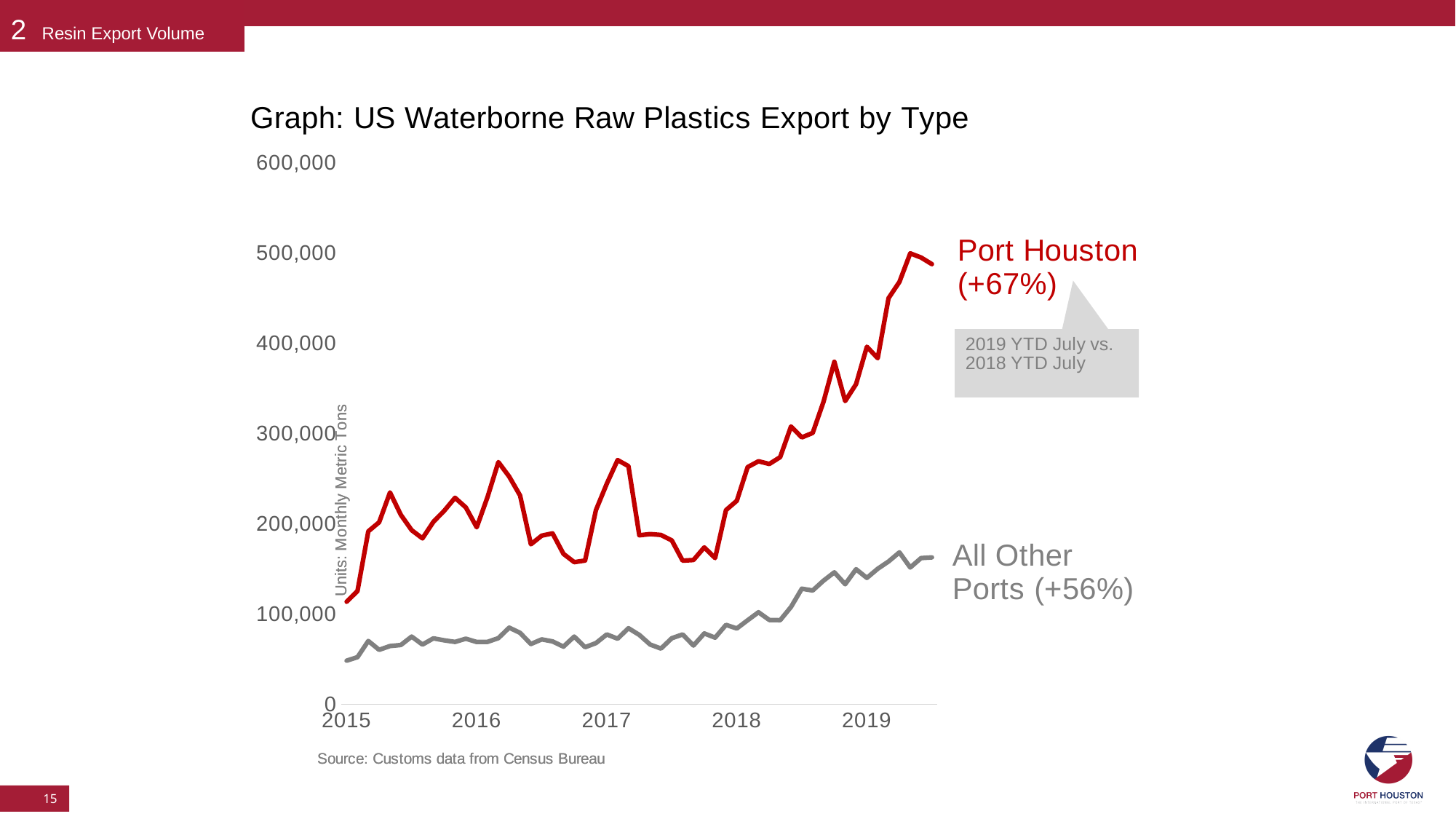
Which series has the higher values in 2019, Port Houston or All Other Ports? Port Houston Does the Port Houston line generally rise or fall from 2015 to 2019? Rise What percentage change is shown next to the All Other Ports line? +56% Is the value for All Other Ports at the start of 2015 greater or less than 100,000? less What kind of chart is shown on the slide? Line chart What percentage change is shown next to the Port Houston line? +67% What is the title of the chart? Graph: US Waterborne Raw Plastics Export by Type Does the All Other Ports line generally rise or fall from 2015 to 2019? Rise How many series are plotted on the chart? 2 Is the peak value for Port Houston in 2019 greater or less than 400,000? greater Is the highest value for Port Houston during 2017 greater or less than 300,000? less What units are shown on the y axis of the chart? Monthly Metric Tons